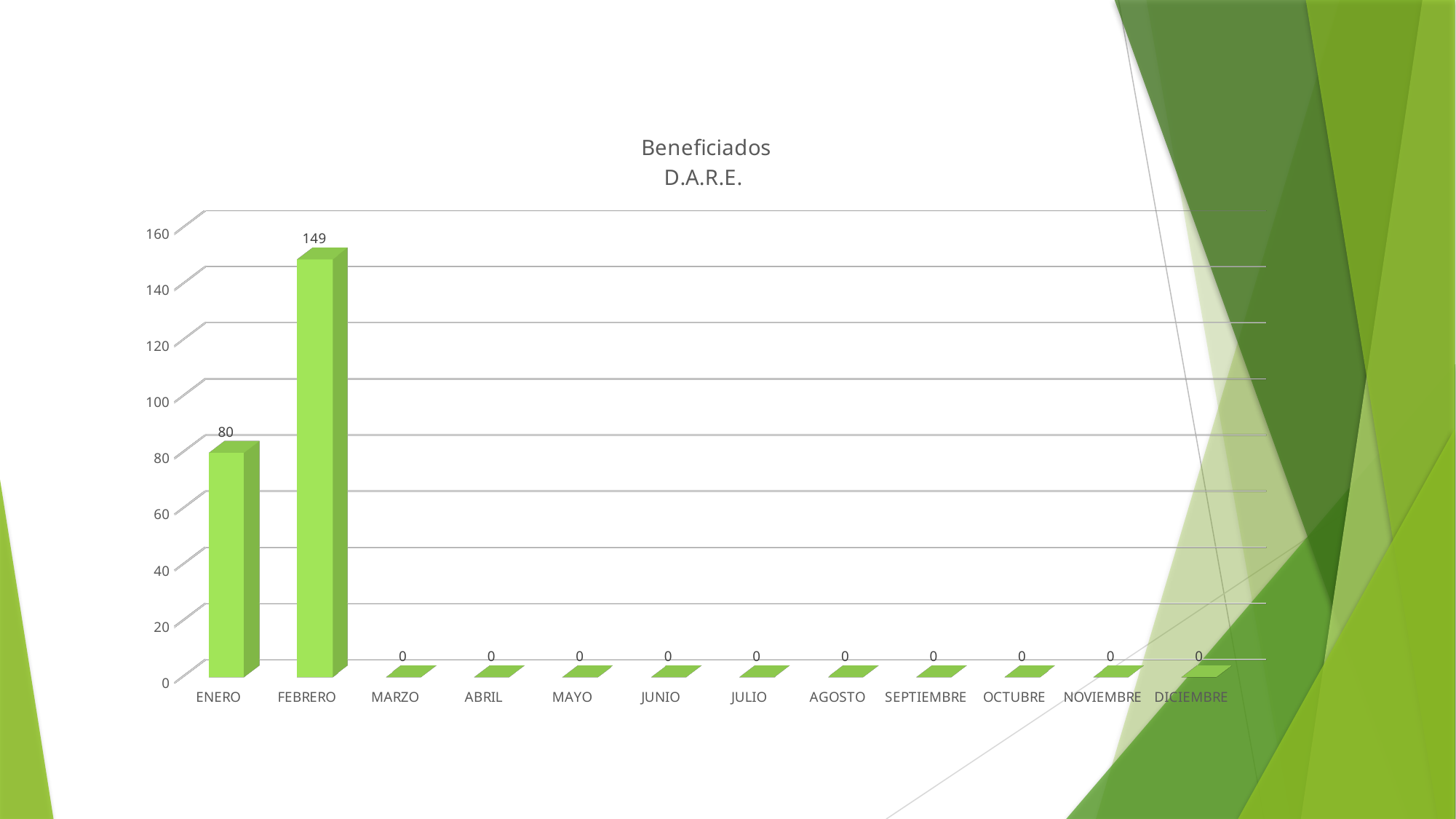
What kind of chart is shown? bar chart What is the value for FEBRERO? 149 What is the value for ENERO? 80 How many months have a value of 0? 10 Which month has the highest value? FEBRERO Is the value for FEBRERO greater or less than 140? greater What is the value for DICIEMBRE? 0 What is the value for MARZO? 0 What is the title of the chart? Beneficiados D.A.R.E. How many categories are shown on the x axis? 12 Which is larger, the value for ENERO or the value for FEBRERO? FEBRERO What is the difference between the values for FEBRERO and ENERO? 69